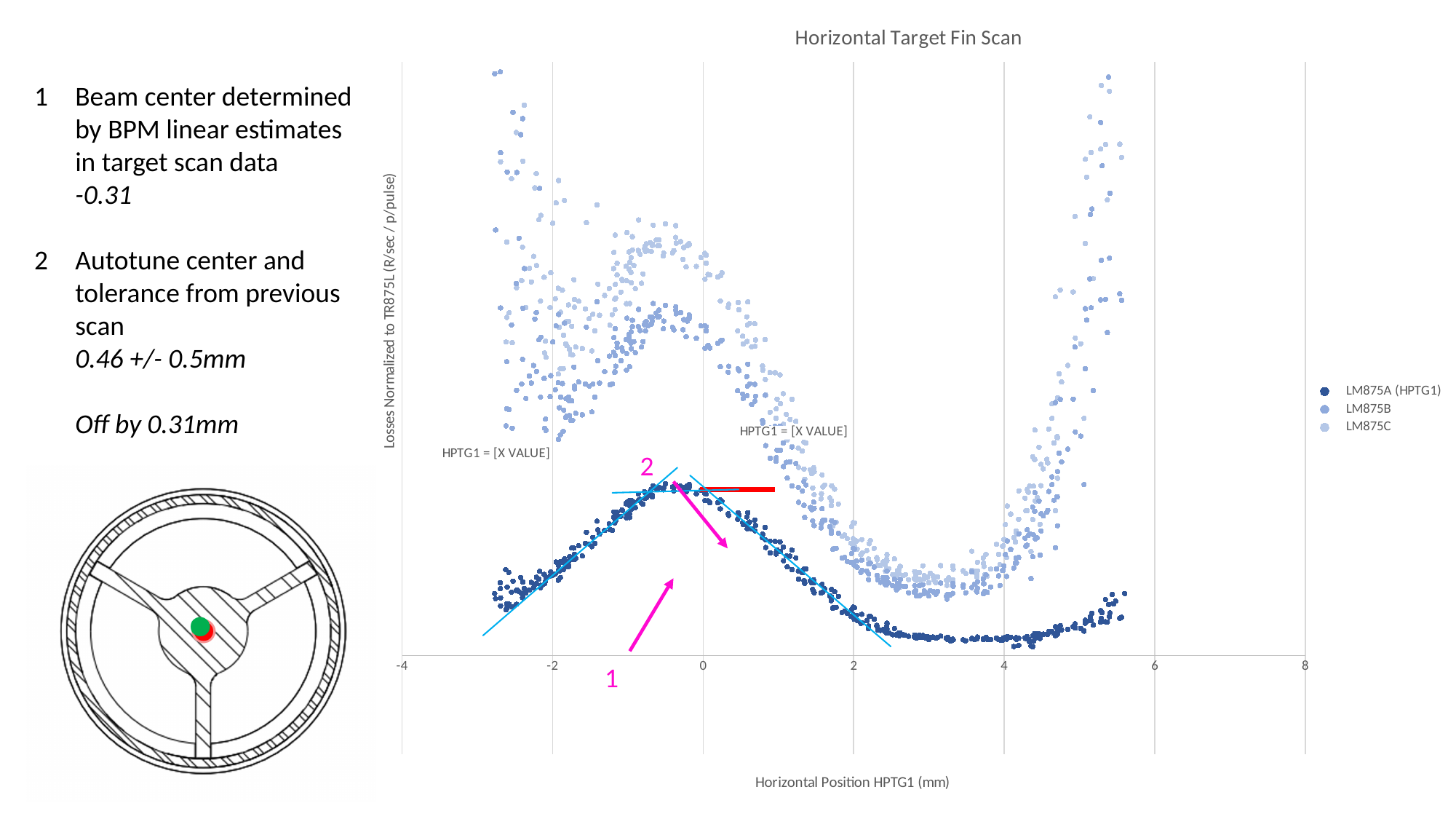
Do the LM875A (HPTG1) values rise or fall as the horizontal position goes from -2 to 0 mm? rise What kind of chart is shown on the slide? scatter chart At a horizontal position of about 4 mm, which series has higher losses, LM875A (HPTG1) or LM875C? LM875C At a horizontal position of about -2 mm, which series has higher losses, LM875A (HPTG1) or LM875B? LM875B Do the LM875A (HPTG1) values rise or fall as the horizontal position goes from 0 to 2 mm? fall What is the label of the chart's x axis? Horizontal Position HPTG1 (mm) What is the title of the chart? Horizontal Target Fin Scan How many series does the chart legend list? 3 Which series has the lowest losses across the whole scan? LM875A (HPTG1)